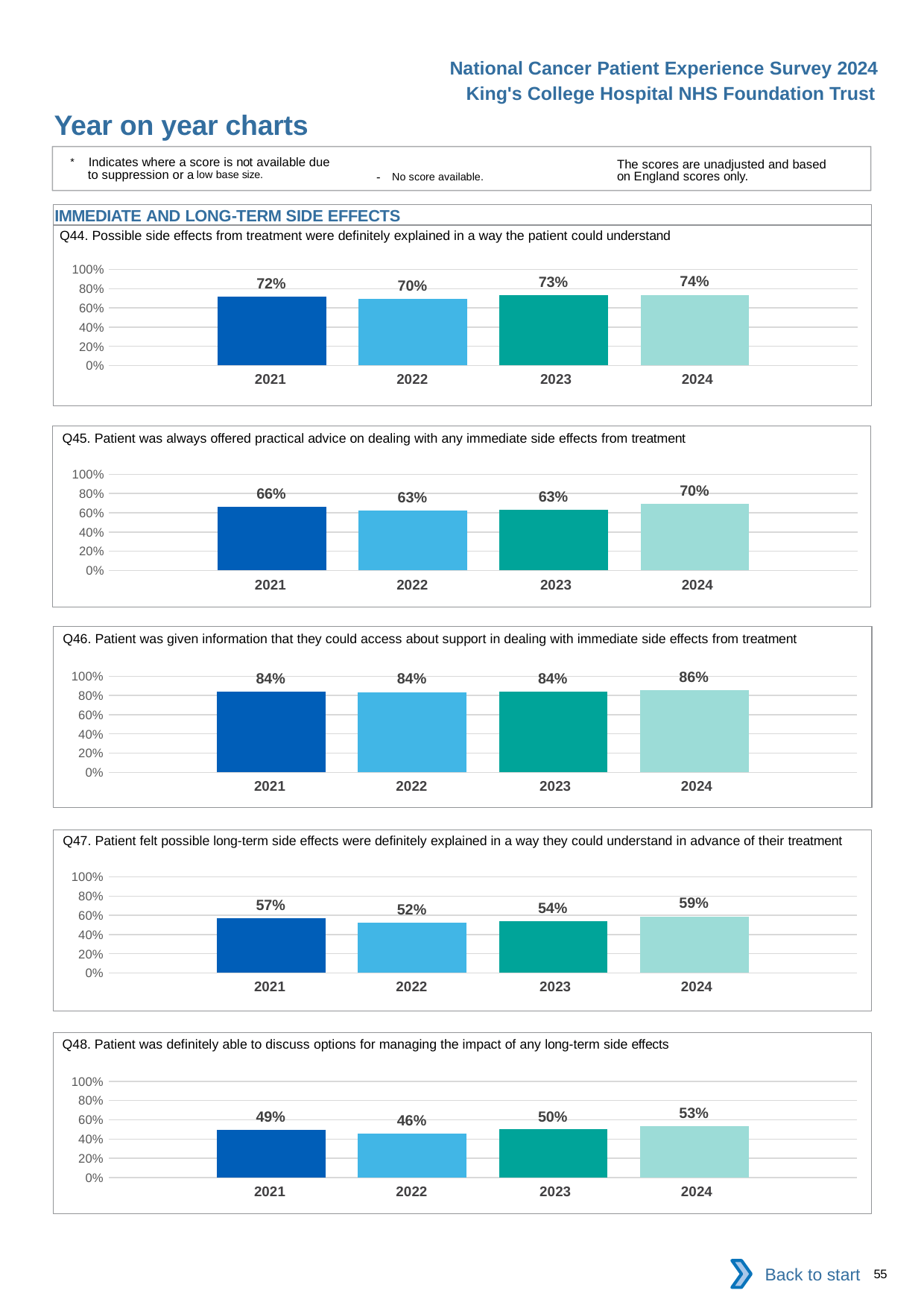
In the Q47 chart, is the value for 2021 larger than the value for 2023? Yes In the Q44 chart, is the value for 2022 greater or less than 80%? less How many years are shown in the Q44 chart? 4 In the Q44 chart, what is the value for 2024? 74% What kind of chart is the Q46 chart? bar chart In the Q48 chart, what is the value for 2022? 46% In the Q46 chart, what is the value for 2021? 84% In the Q47 chart, which year has the lowest value? 2022 In the Q45 chart, which year has the highest value? 2024 In the Q48 chart, is the value for 2024 greater or less than 60%? less In the Q45 chart, what is the difference between the 2024 and 2022 values? 7% In the Q48 chart, what is the difference between the 2024 and 2021 values? 4%